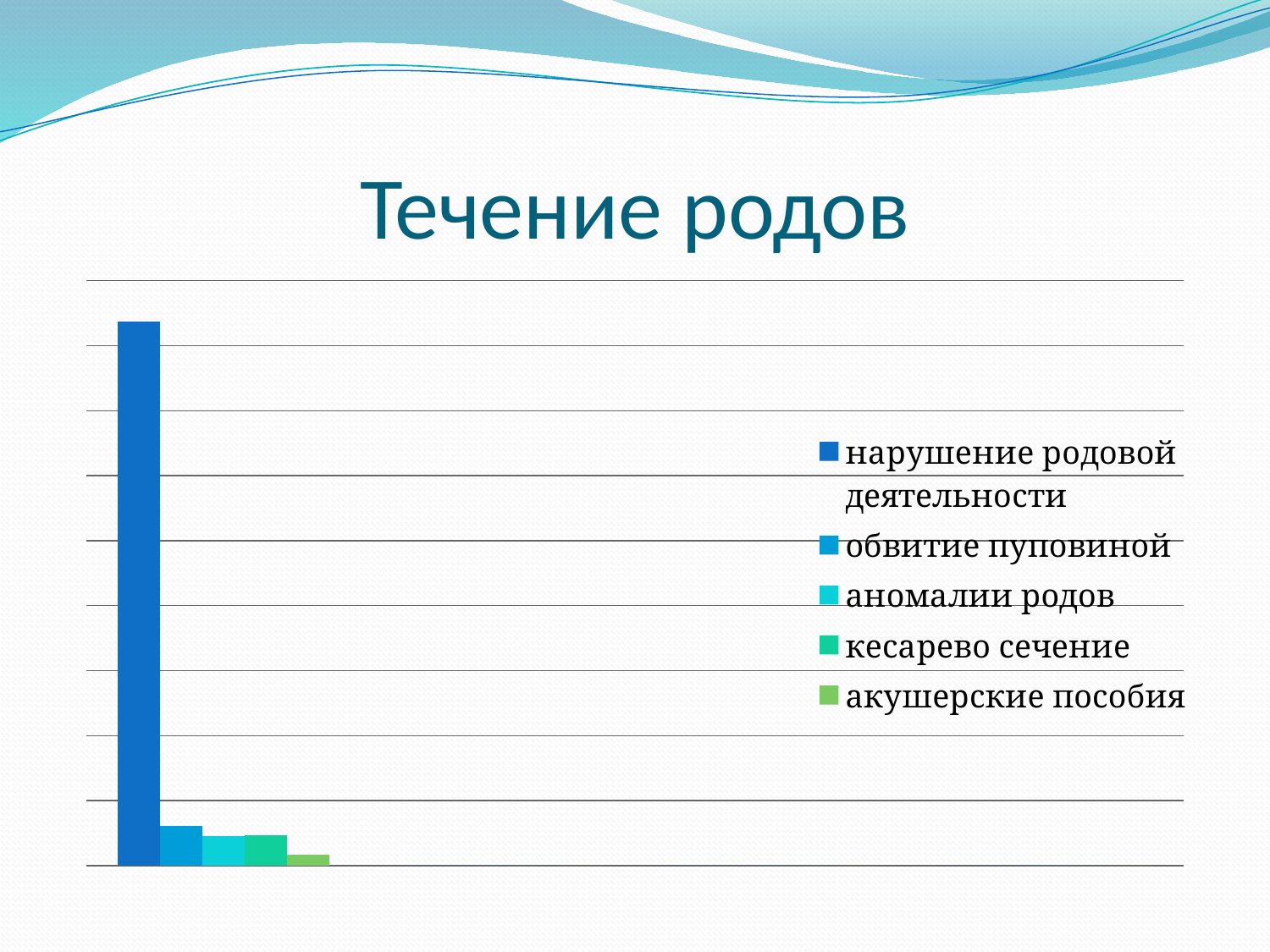
Which series has the lowest value? акушерские пособия How many series does the legend list? 5 What kind of chart is shown on the slide? bar chart Which is larger, the value for обвитие пуповиной or the value for акушерские пособия? обвитие пуповиной Which is larger, the value for кесарево сечение or the value for акушерские пособия? кесарево сечение Which series has the highest value? нарушение родовой деятельности Which is larger, the value for нарушение родовой деятельности or the value for обвитие пуповиной? нарушение родовой деятельности How many bars are plotted in the chart? 5 What is the title of the slide? Течение родов Which legend entry is listed last? акушерские пособия